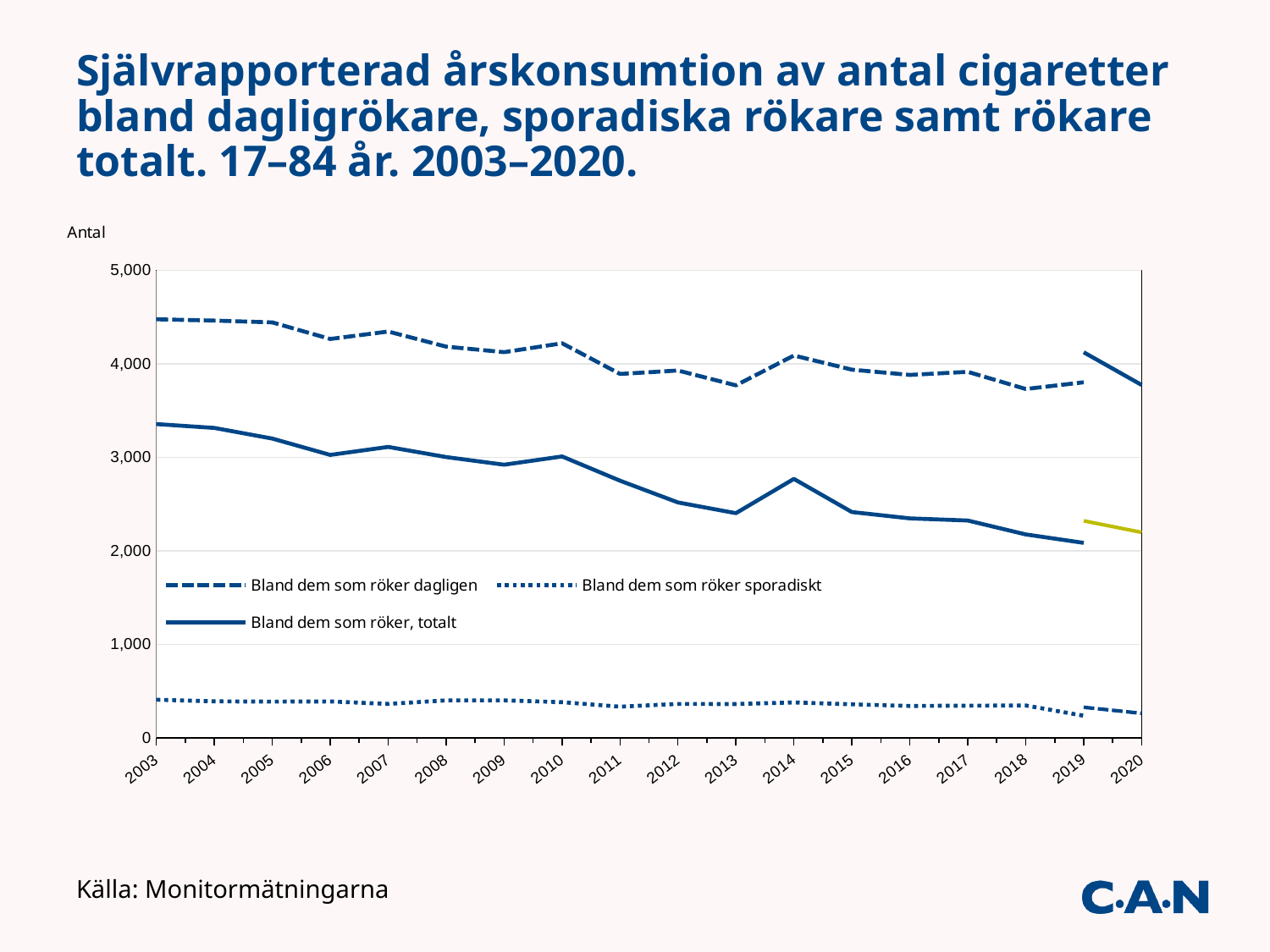
Is the value for 'Bland dem som röker sporadiskt' in 2003 greater or less than 1,000? less Is the value for 'Bland dem som röker dagligen' in 2013 greater or less than 4,000? less How many series does the legend list? 3 What is the label on the vertical axis of the chart? Antal In 2003, which is larger: the value for 'Bland dem som röker, totalt' or for 'Bland dem som röker sporadiskt'? Bland dem som röker, totalt Is the value for 'Bland dem som röker dagligen' in 2003 greater or less than 4,000? greater What kind of chart is shown on the slide? line chart Which series has the highest values throughout the chart? Bland dem som röker dagligen Does the 'Bland dem som röker, totalt' series generally rise or fall from 2003 to 2019? fall How many years are shown on the x axis? 18